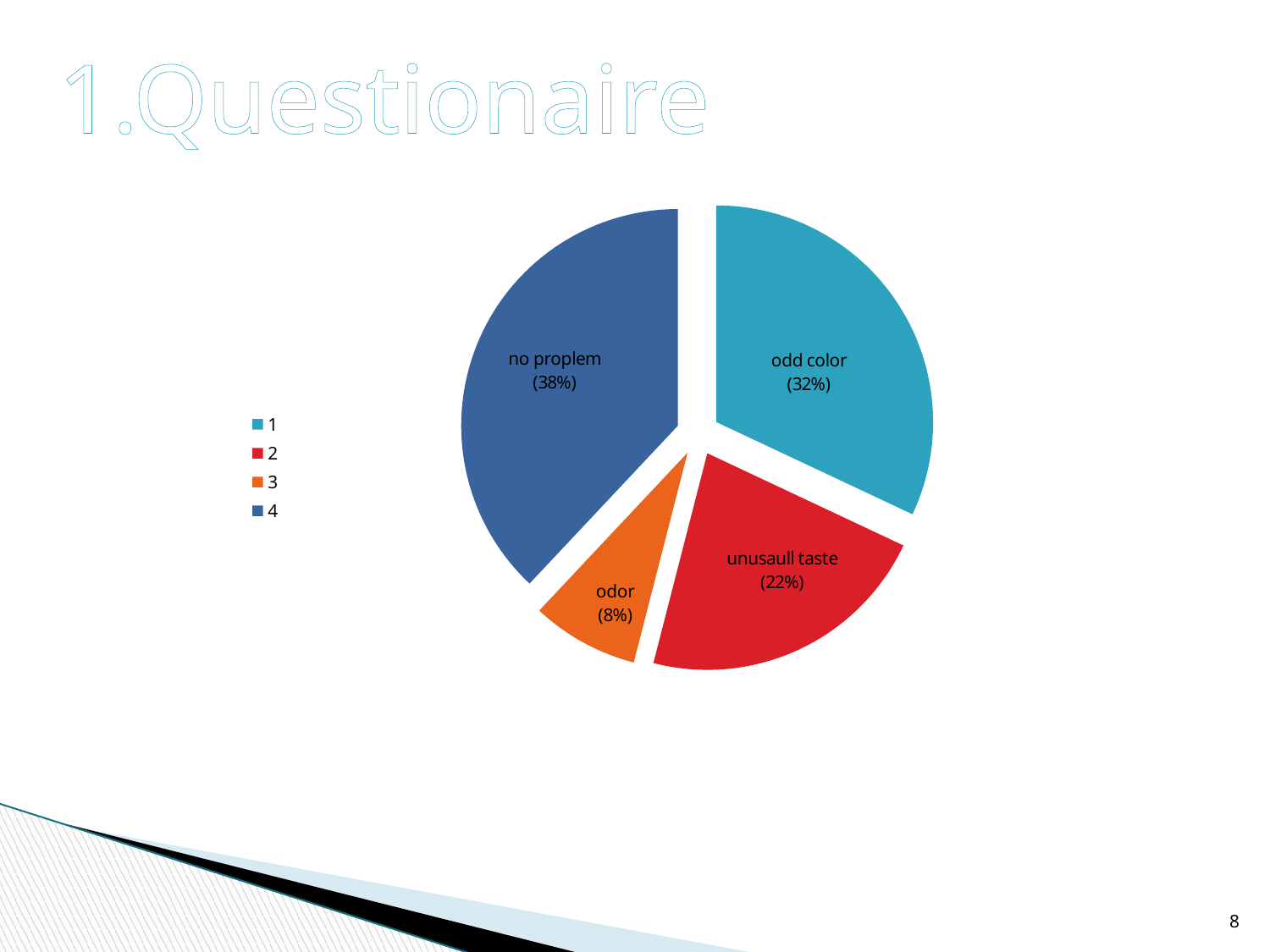
What is the difference in percentage points between the "no proplem" slice and the "odd color" slice? 6 What share of the pie does the "unusaull taste" slice represent? 22% What colour is the "unusaull taste" slice? red What share of the pie does the "no proplem" slice represent? 38% Which slice of the pie is the largest? no proplem How many slices does the pie chart have? 4 How many entries does the legend list? 4 Which slice of the pie is the smallest? odor What kind of chart is shown on the slide? pie chart What share of the pie does the "odd color" slice represent? 32% Which slice is larger, "unusaull taste" or "odor"? unusaull taste